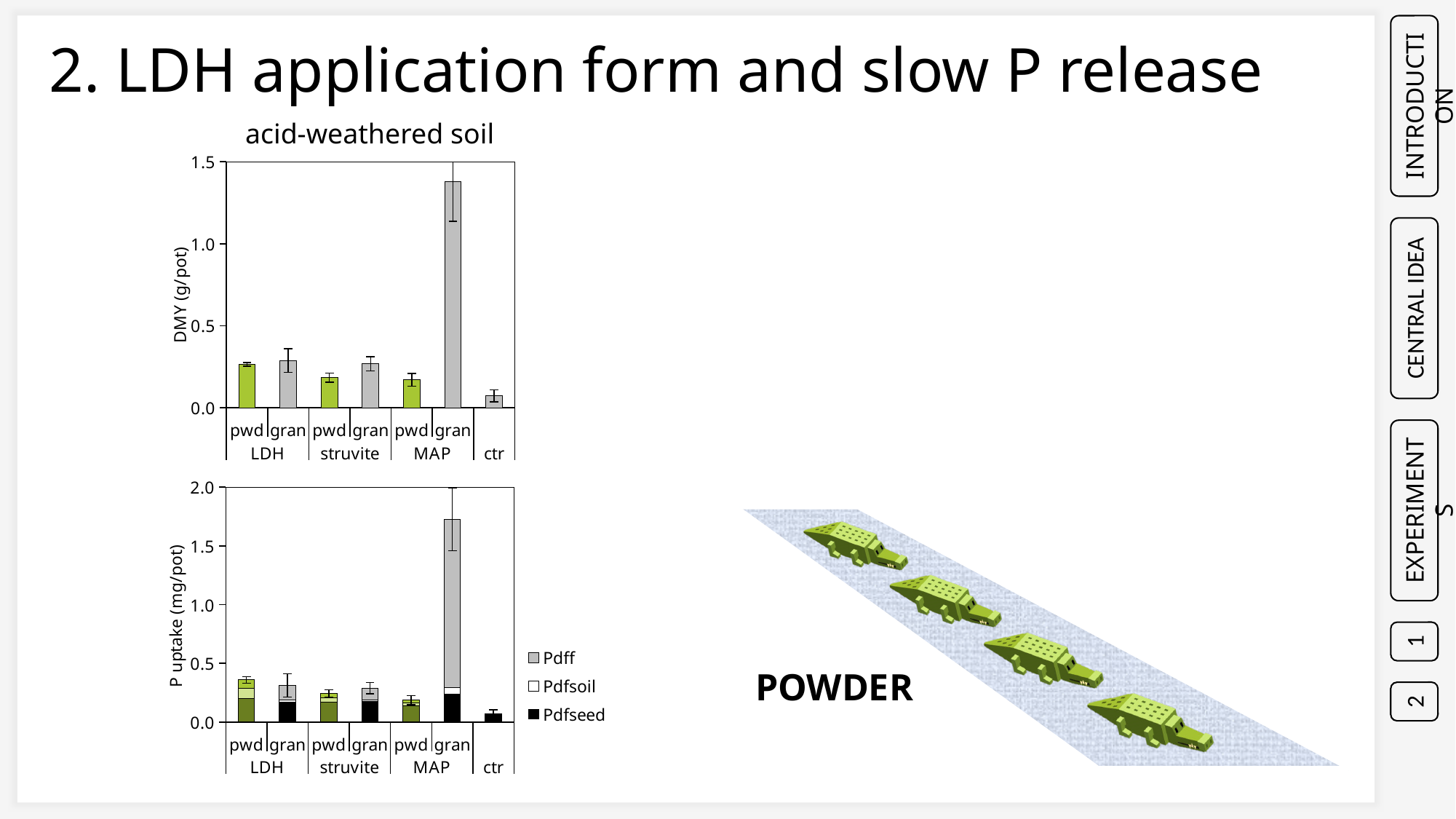
In the top chart (DMY), is the value for LDH pwd greater or less than 0.5? less In the bottom chart (P uptake), which bar has the lowest total? ctr What kind of chart is the top chart titled 'acid-weathered soil'? bar chart How many bars are plotted in the top chart (DMY)? 7 In the top chart (DMY), which bar has the highest value? MAP gran In the top chart (DMY), is the value for MAP gran greater or less than 1.0? greater In the bottom chart (P uptake), which bar has the highest total? MAP gran In the top chart (DMY), which bar has the lowest value? ctr In the top chart (DMY), which is larger: MAP gran or struvite gran? MAP gran In the bottom chart (P uptake), is the total for MAP gran greater or less than 1.5? greater What is the y-axis label of the bottom chart? P uptake (mg/pot) How many series does the legend of the bottom chart (P uptake) list? 3